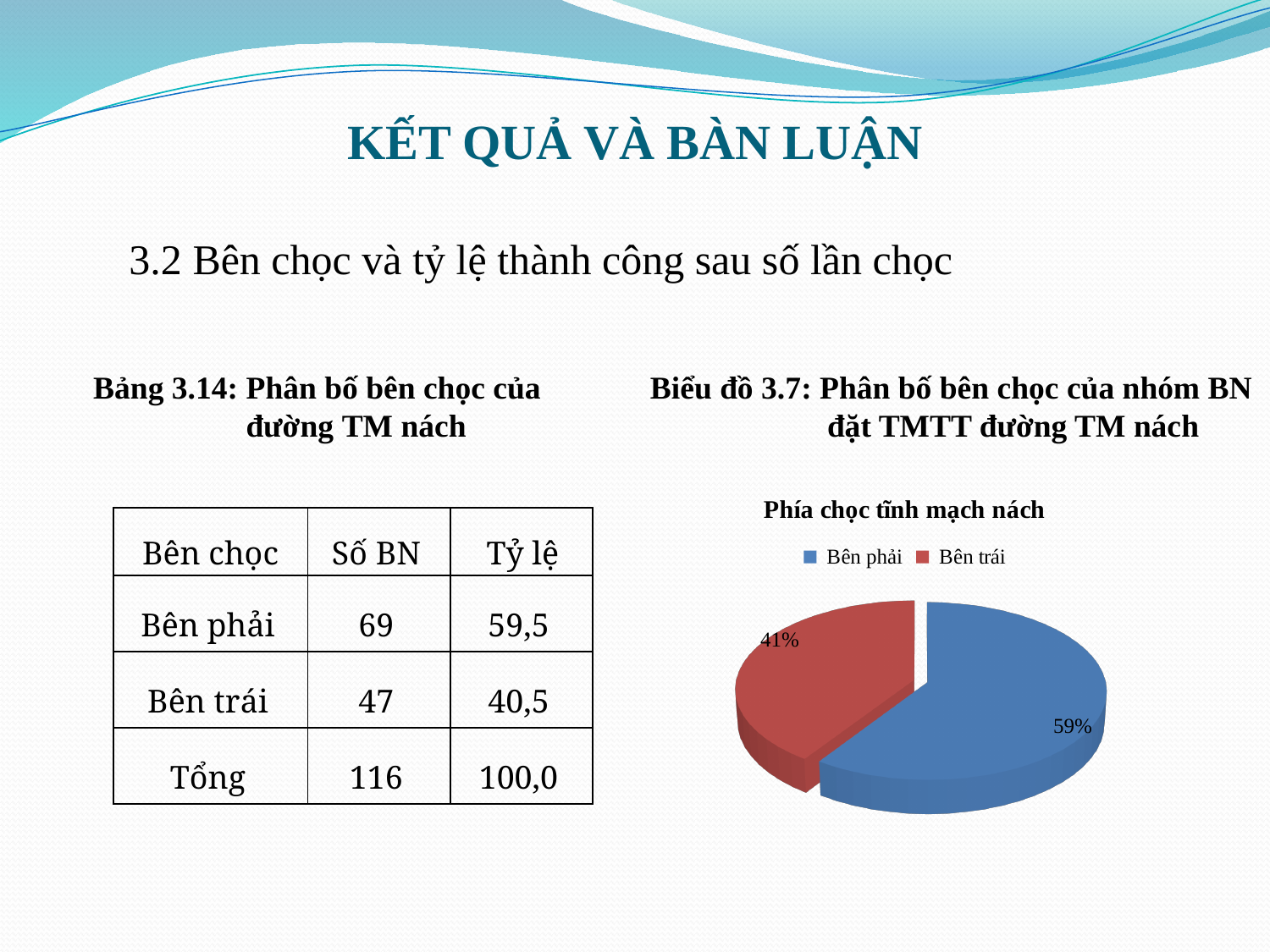
Which is larger in the pie chart, Bên phải or Bên trái? Bên phải Which slice of the pie chart is the largest? Bên phải How many entries does the pie chart's legend list? 2 What share of the pie does Bên trái represent? 41% What share of the pie does Bên phải represent? 59% What is the difference in percentage points between the Bên phải and Bên trái slices? 18% Which slice of the pie chart is the smallest? Bên trái What kind of chart is shown on the slide? pie chart Which colour represents Bên trái in the pie chart? red How many slices does the pie chart have? 2 What is the title of the pie chart? Phía chọc tĩnh mạch nách